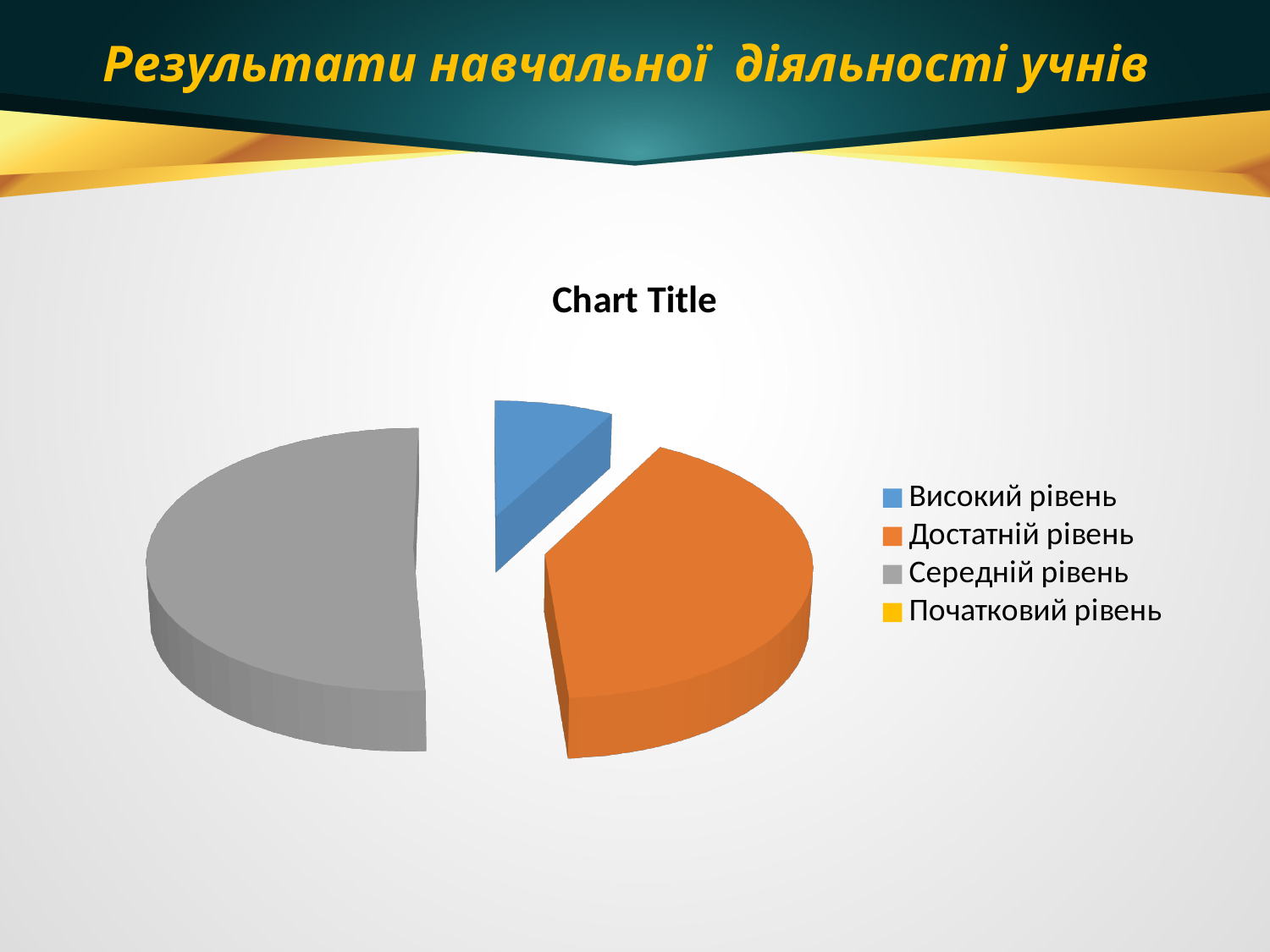
Which colour represents Високий рівень in the pie chart? blue Which is larger, the slice for Достатній рівень or the slice for Високий рівень? Достатній рівень Which is larger, the slice for Середній рівень or the slice for Високий рівень? Середній рівень Which legend entry is listed last in the chart legend? Початковий рівень Which category is shown in orange in the pie chart? Достатній рівень How many categories does the chart legend list? 4 Which category has the largest slice of the pie? Середній рівень What kind of chart is shown on the slide? pie chart Which is larger, the slice for Середній рівень or the slice for Достатній рівень? Середній рівень